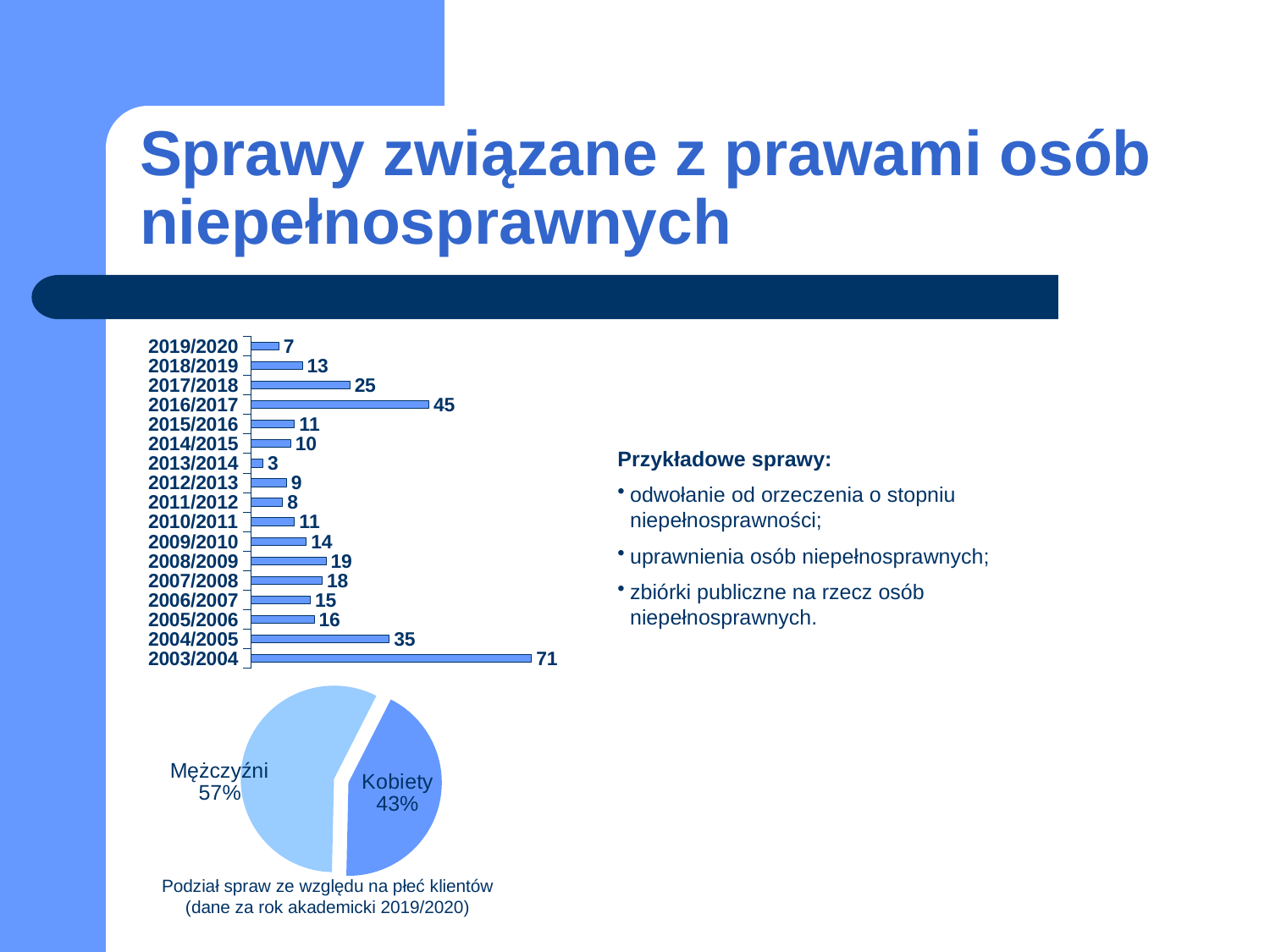
In the bar chart at the top left, which academic year has the highest value? 2003/2004 In the pie chart 'Podział spraw ze względu na płeć klientów', what share is Kobiety? 43% In the bar chart at the top left, which is larger, the value for 2008/2009 or the value for 2007/2008? 2008/2009 In the bar chart at the top left, how many academic years are shown? 17 In the bar chart at the top left, what is the value for 2003/2004? 71 In the pie chart 'Podział spraw ze względu na płeć klientów', how many slices are there? 2 In the bar chart at the top left, what is the difference between the values for 2003/2004 and 2004/2005? 36 In the bar chart at the top left, which academic year has the lowest value? 2013/2014 In the bar chart at the top left, what is the value for 2016/2017? 45 In the pie chart 'Podział spraw ze względu na płeć klientów', which slice is larger, Mężczyźni or Kobiety? Mężczyźni What kind of chart is the chart at the top left of the slide? Bar chart In the bar chart at the top left, what is the value for 2019/2020? 7